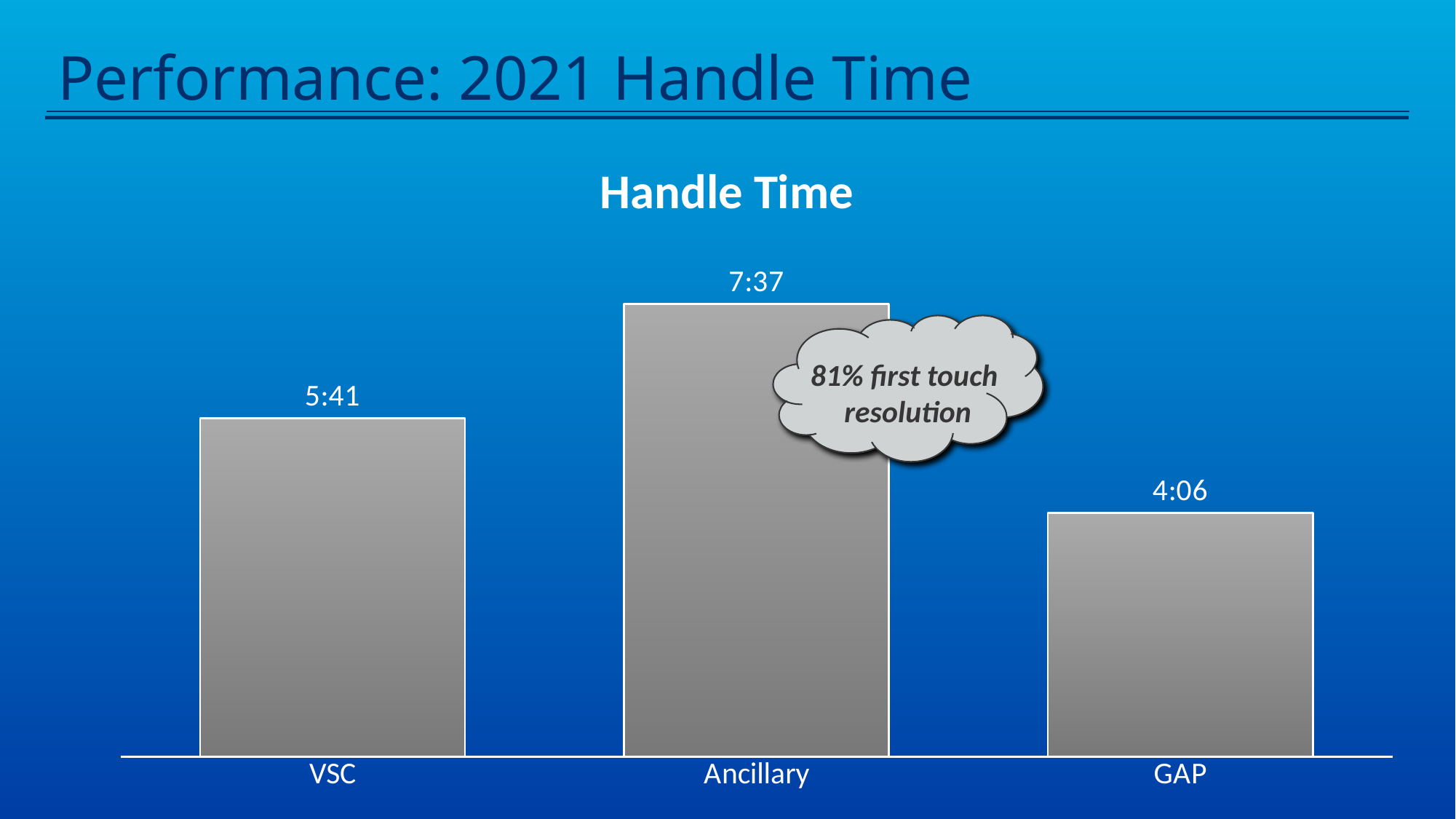
How much longer is the handle time for VSC than for GAP? 1:35 How many categories are shown in the chart? 3 Which category has the highest handle time? Ancillary What is the title of the chart? Handle Time What is the handle time for GAP? 4:06 Which has a longer handle time, VSC or GAP? VSC What is the handle time for Ancillary? 7:37 What type of chart is shown on the slide? Bar chart Which has a longer handle time, Ancillary or VSC? Ancillary What is the handle time for VSC? 5:41 Which category has the lowest handle time? GAP How much longer is the handle time for Ancillary than for VSC? 1:56